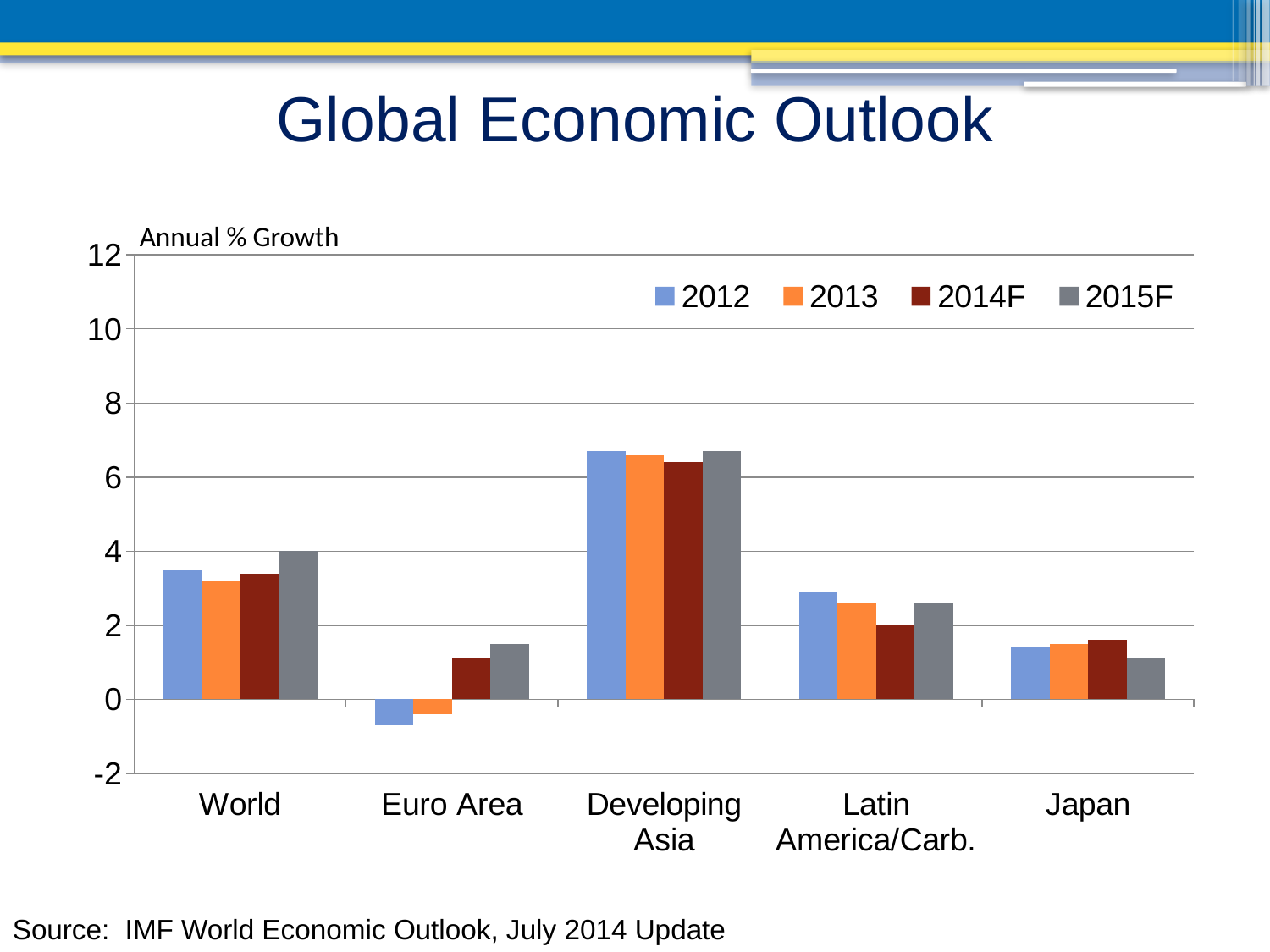
Is the 2015F value for Developing Asia greater or less than 6? greater Do the Euro Area values rise or fall from 2012 to 2015F? Rise How many series does the legend list? 4 How many regions/categories are shown on the x axis? 5 Which is larger, the 2014F value for Euro Area or the 2014F value for Japan? Japan What kind of chart is shown on the slide? Bar chart Is the 2012 value for Euro Area greater or less than 0? less Which category has the highest value for 2012? Developing Asia Which is larger, the 2015F value for World or the 2015F value for Latin America/Carb.? World What is the label shown above the vertical axis of the chart? Annual % Growth Is the 2015F value for Japan greater or less than 2? less Which category has the lowest value for 2012? Euro Area